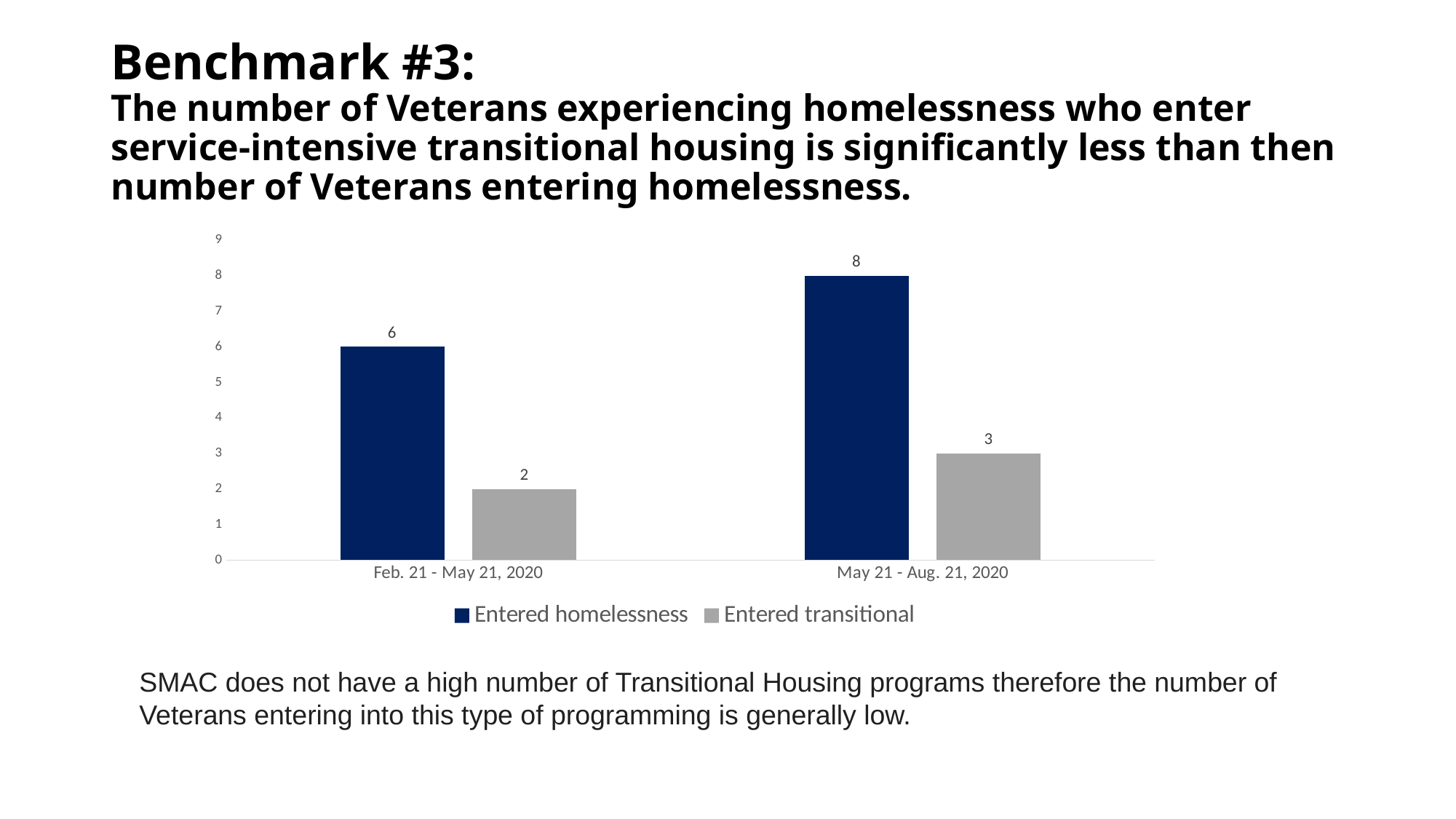
What is the value for Entered homelessness in Feb. 21 - May 21, 2020? 6 What is the value for Entered homelessness in May 21 - Aug. 21, 2020? 8 Which period has the highest value for Entered homelessness? May 21 - Aug. 21, 2020 Which period has the lowest value for Entered transitional? Feb. 21 - May 21, 2020 How many series does the legend list? 2 How many periods are shown on the x axis? 2 What kind of chart is shown on the slide? Bar chart What is the difference between Entered homelessness and Entered transitional in May 21 - Aug. 21, 2020? 5 Does the value for Entered homelessness rise or fall from Feb. 21 - May 21, 2020 to May 21 - Aug. 21, 2020? Rise Which is larger in Feb. 21 - May 21, 2020: Entered homelessness or Entered transitional? Entered homelessness What is the value for Entered transitional in Feb. 21 - May 21, 2020? 2 What is the value for Entered transitional in May 21 - Aug. 21, 2020? 3